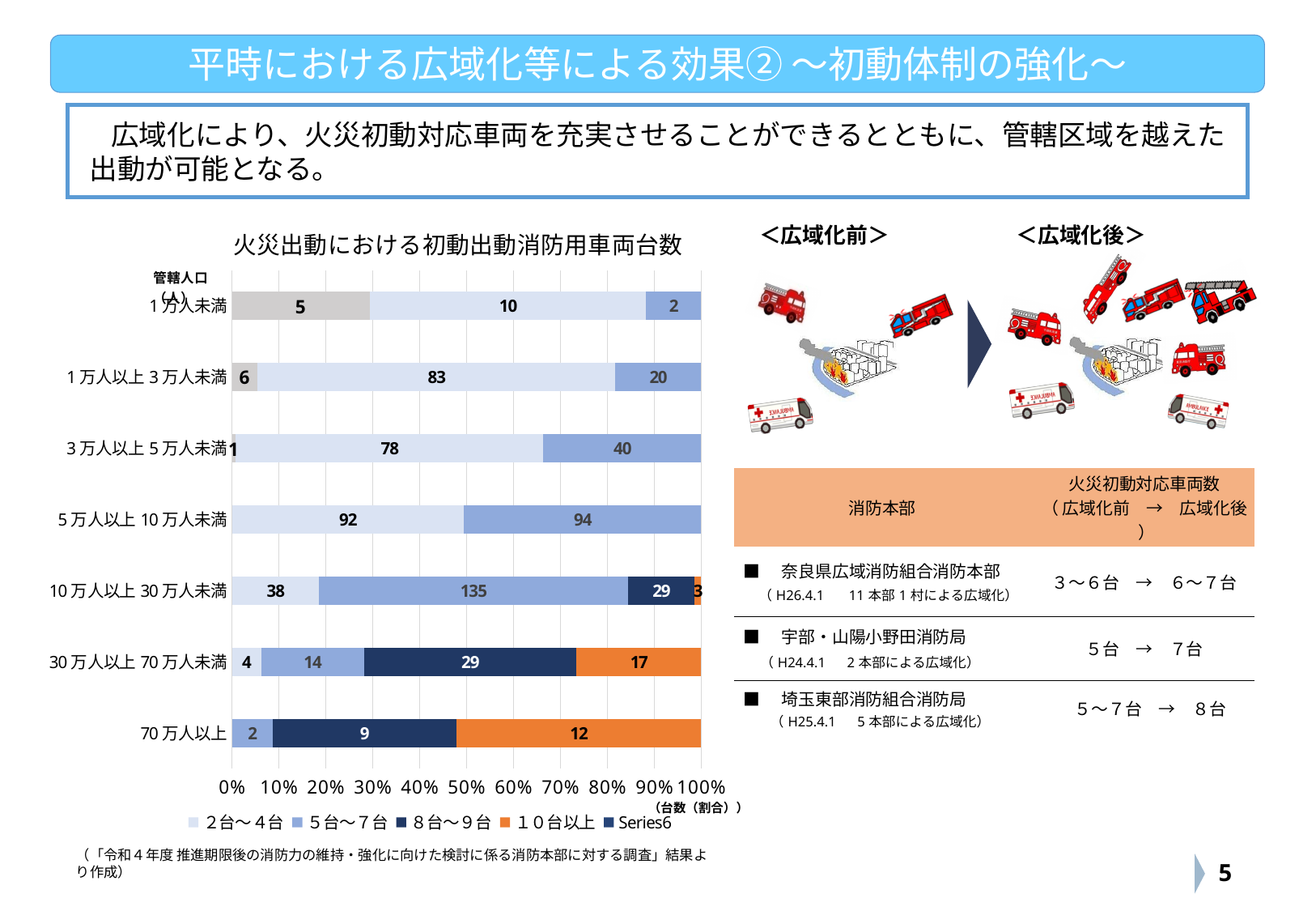
Which segment in the 10万人以上30万人未満 bar has the highest value? 5台〜7台 What is the value of the 10台以上 segment for 70万人以上? 12 What is the total of the labelled segments in the 70万人以上 bar? 23 What is the title of the chart? 火災出動における初動出動消防用車両台数 What is the value of the 5台〜7台 segment for 10万人以上30万人未満? 135 How many population categories are plotted on the chart? 7 What is the value of the 2台〜4台 segment for 1万人以上3万人未満? 83 For 5万人以上10万人未満, what is the difference between the 5台〜7台 segment and the 2台〜4台 segment? 2 For 5万人以上10万人未満, which segment is larger: 2台〜4台 or 5台〜7台? 5台〜7台 How many series does the chart legend list? 5 What kind of chart is shown on the slide? bar chart What is the value of the 8台〜9台 segment for 30万人以上70万人未満? 29